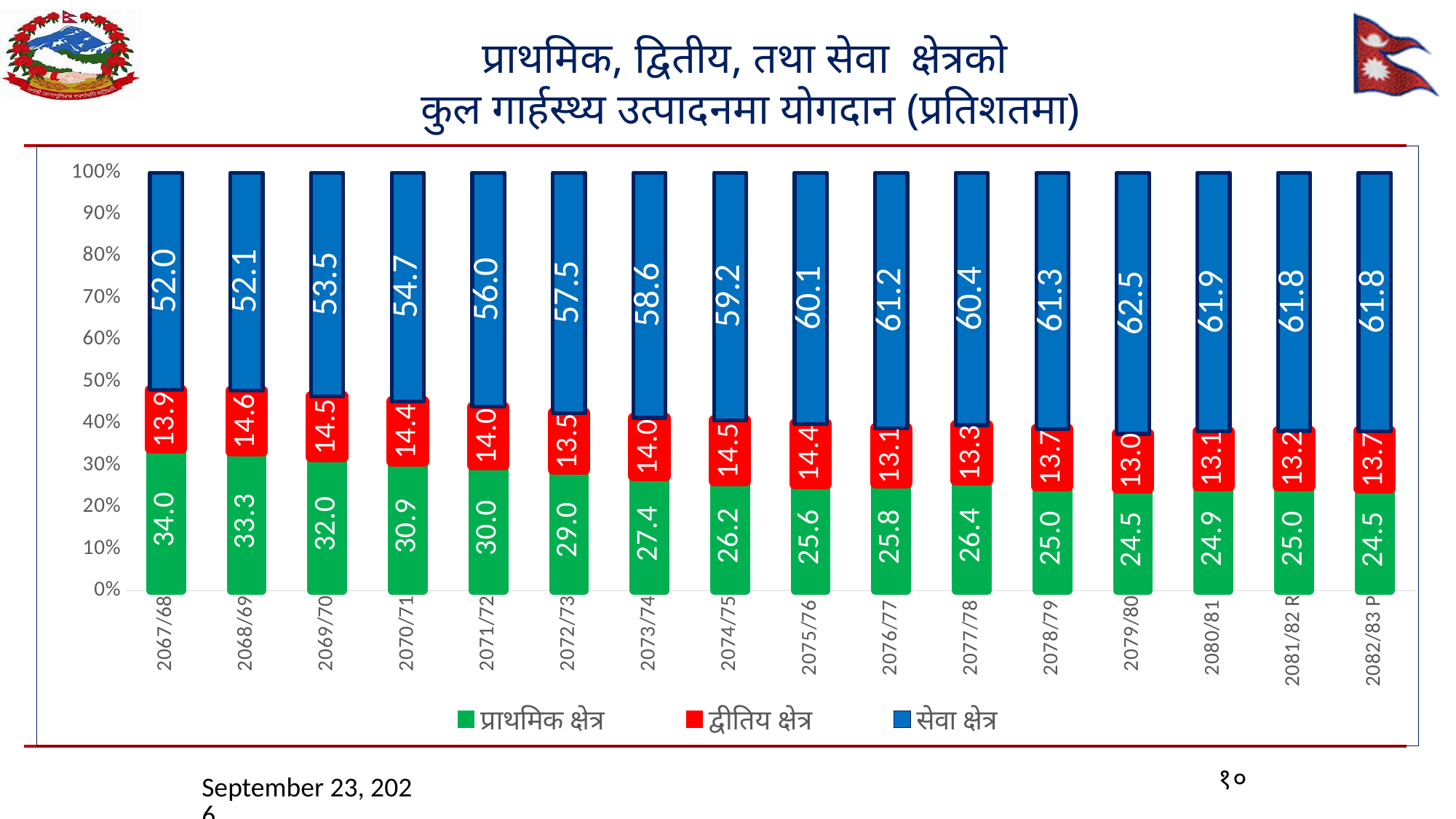
Which is larger: the सेवा क्षेत्र value for 2076/77 or for 2077/78? 2076/77 What is the value of द्वीतिय क्षेत्र for 2075/76? 14.4 What is the value of प्राथमिक क्षेत्र for 2067/68? 34.0 How many years (categories) are shown on the x axis? 16 What is the difference between the प्राथमिक क्षेत्र value for 2067/68 and for 2082/83 P? 9.5 In which year is the सेवा क्षेत्र value lowest? 2067/68 How many series does the legend list? 3 Does the प्राथमिक क्षेत्र value generally rise or fall from 2067/68 to 2082/83 P? Fall In which year is the सेवा क्षेत्र value highest? 2079/80 What is the value of सेवा क्षेत्र for 2082/83 P? 61.8 In which year is the द्वीतिय क्षेत्र value lowest? 2079/80 What kind of chart is shown on the slide? Stacked bar chart